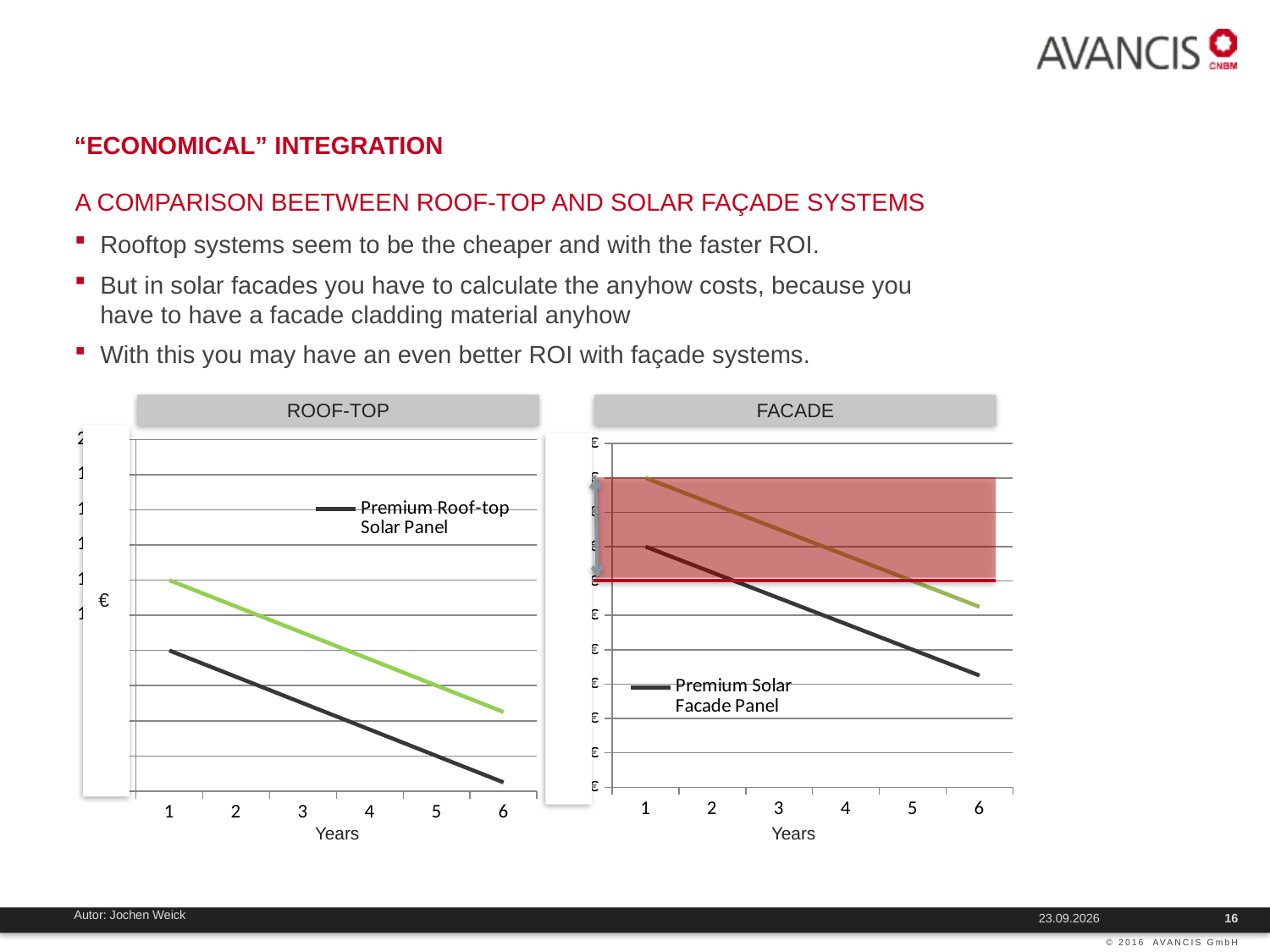
What kind of chart is the ROOF-TOP chart? line chart In the ROOF-TOP chart, which line is higher at year 6, the green line or the black line? the green line How many year points are shown on the x axis of the FACADE chart? 6 In the FACADE chart, do the plotted values rise or fall as the years increase? fall What is the x-axis label of the FACADE chart? Years What kind of chart is the FACADE chart? line chart What legend entry is shown in the ROOF-TOP chart? Premium Roof-top Solar Panel How many year points are shown on the x axis of the ROOF-TOP chart? 6 In the FACADE chart, which line is higher at year 1, the brown line or the black line? the brown line What is the title of the chart on the right side of the slide? FACADE In the ROOF-TOP chart, do the plotted values rise or fall as the years increase? fall